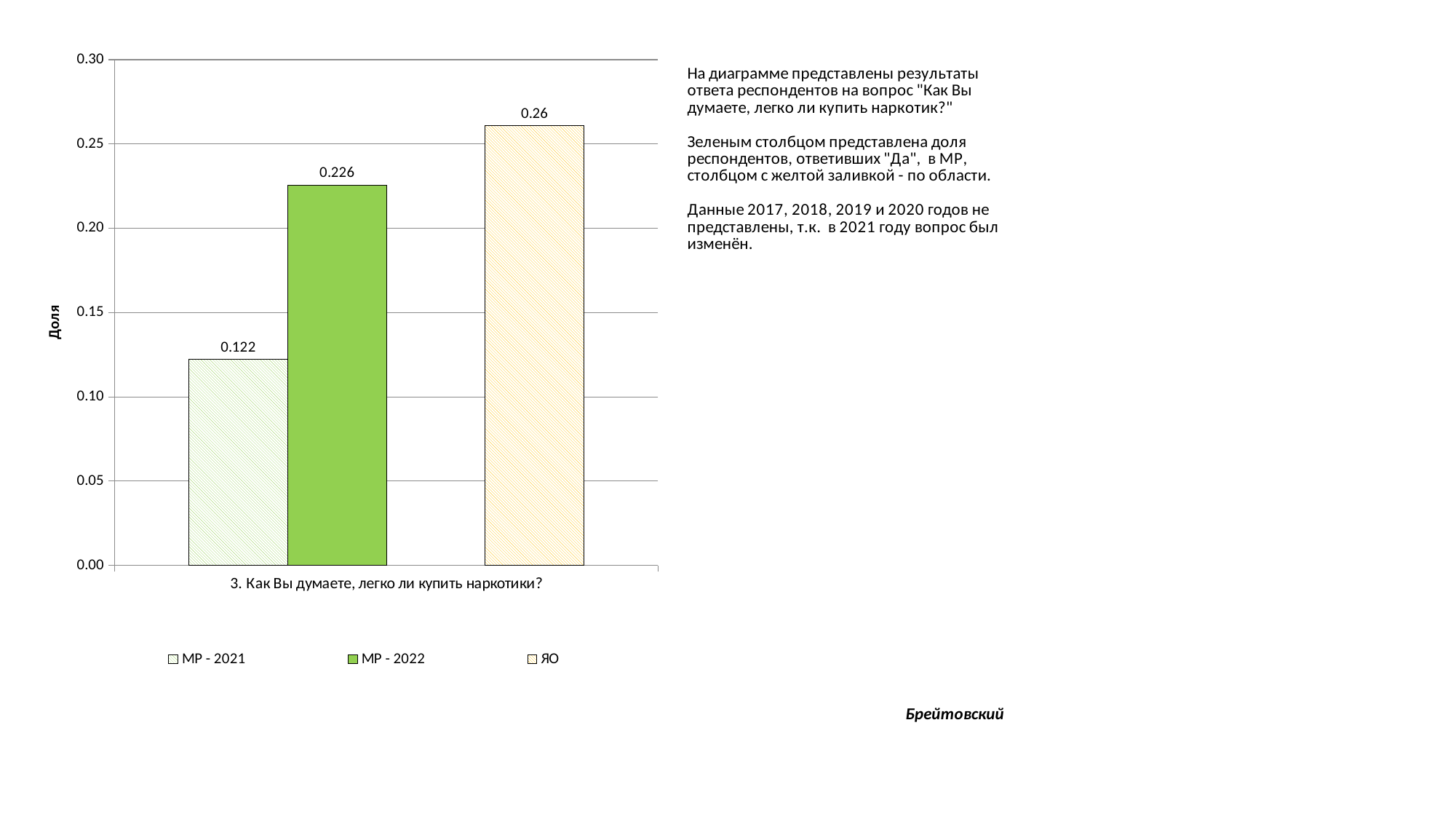
Which series has the highest value? ЯО Which is larger, the value for МР - 2021 or the value for ЯО? ЯО Is the value for МР - 2022 greater or less than 0.20? greater What is the label of the vertical axis? Доля What is the value for МР - 2021? 0.122 What kind of chart is shown on the slide? bar chart What is the value for ЯО? 0.26 Which series has the lowest value? МР - 2021 What is the value for МР - 2022? 0.226 What is the difference between the values for ЯО and МР - 2022? 0.034 What is the difference between the values for МР - 2022 and МР - 2021? 0.104 How many series does the legend list? 3